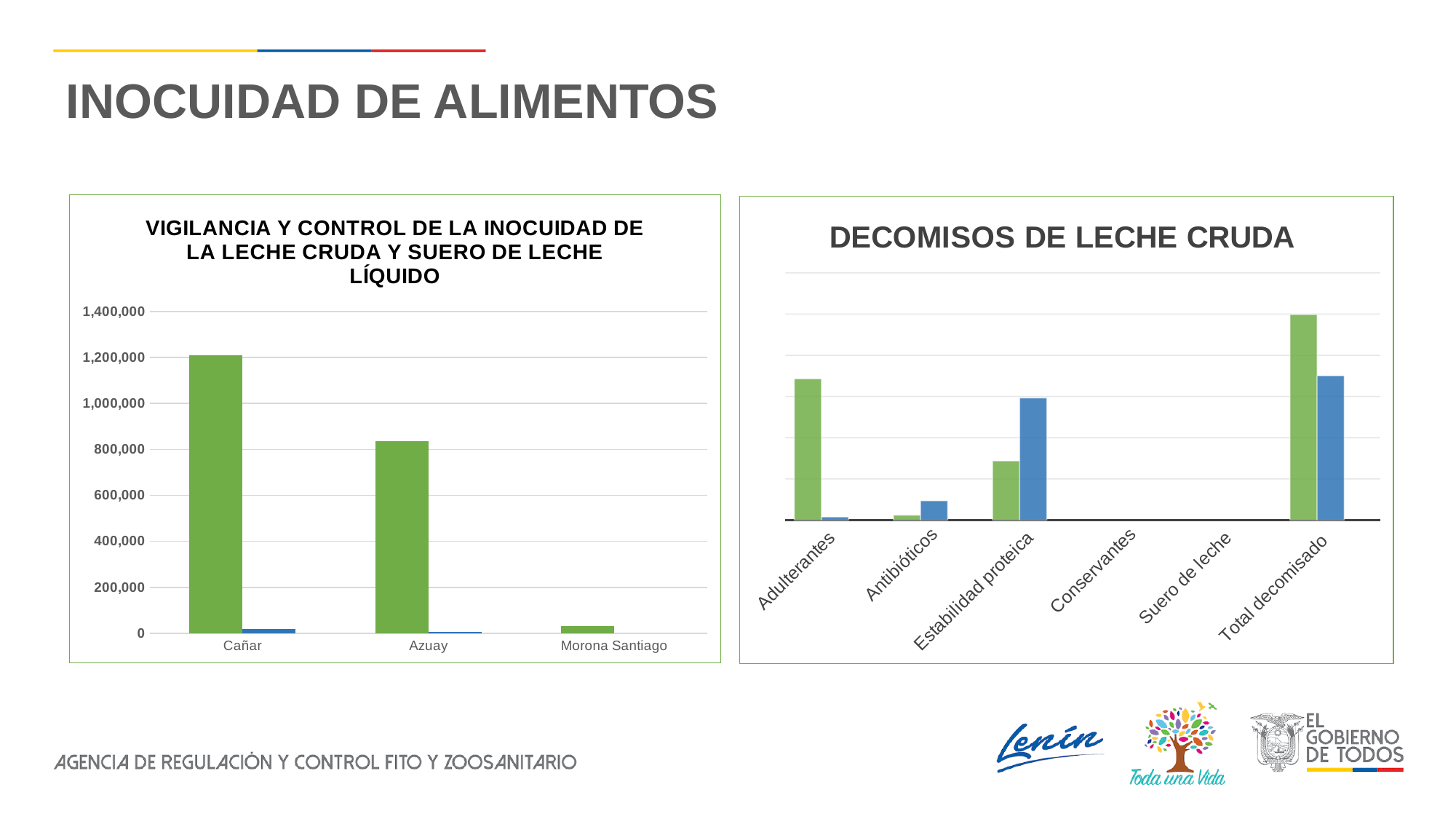
In the left chart (VIGILANCIA Y CONTROL), which category has the tallest green bar? Cañar In the left chart (VIGILANCIA Y CONTROL), is the green bar for Azuay greater or less than 1,000,000? less In the left chart (VIGILANCIA Y CONTROL), which category has the shortest green bar? Morona Santiago How many categories are shown on the x axis of the left chart (VIGILANCIA Y CONTROL)? 3 In the right chart (DECOMISOS DE LECHE CRUDA), which category has the tallest green bar? Total decomisado In the right chart (DECOMISOS DE LECHE CRUDA), which is larger for Estabilidad proteica, the green bar or the blue bar? The blue bar In the left chart (VIGILANCIA Y CONTROL), which is larger for Cañar, the green bar or the blue bar? The green bar What kind of chart is the right chart titled 'DECOMISOS DE LECHE CRUDA'? Bar chart In the left chart (VIGILANCIA Y CONTROL), is the green bar for Morona Santiago greater or less than 200,000? less What kind of chart is the left chart titled 'VIGILANCIA Y CONTROL DE LA INOCUIDAD DE LA LECHE CRUDA Y SUERO DE LECHE LÍQUIDO'? Bar chart How many categories are listed on the x axis of the right chart (DECOMISOS DE LECHE CRUDA)? 6 In the left chart (VIGILANCIA Y CONTROL), is the green bar for Cañar greater or less than 1,000,000? greater